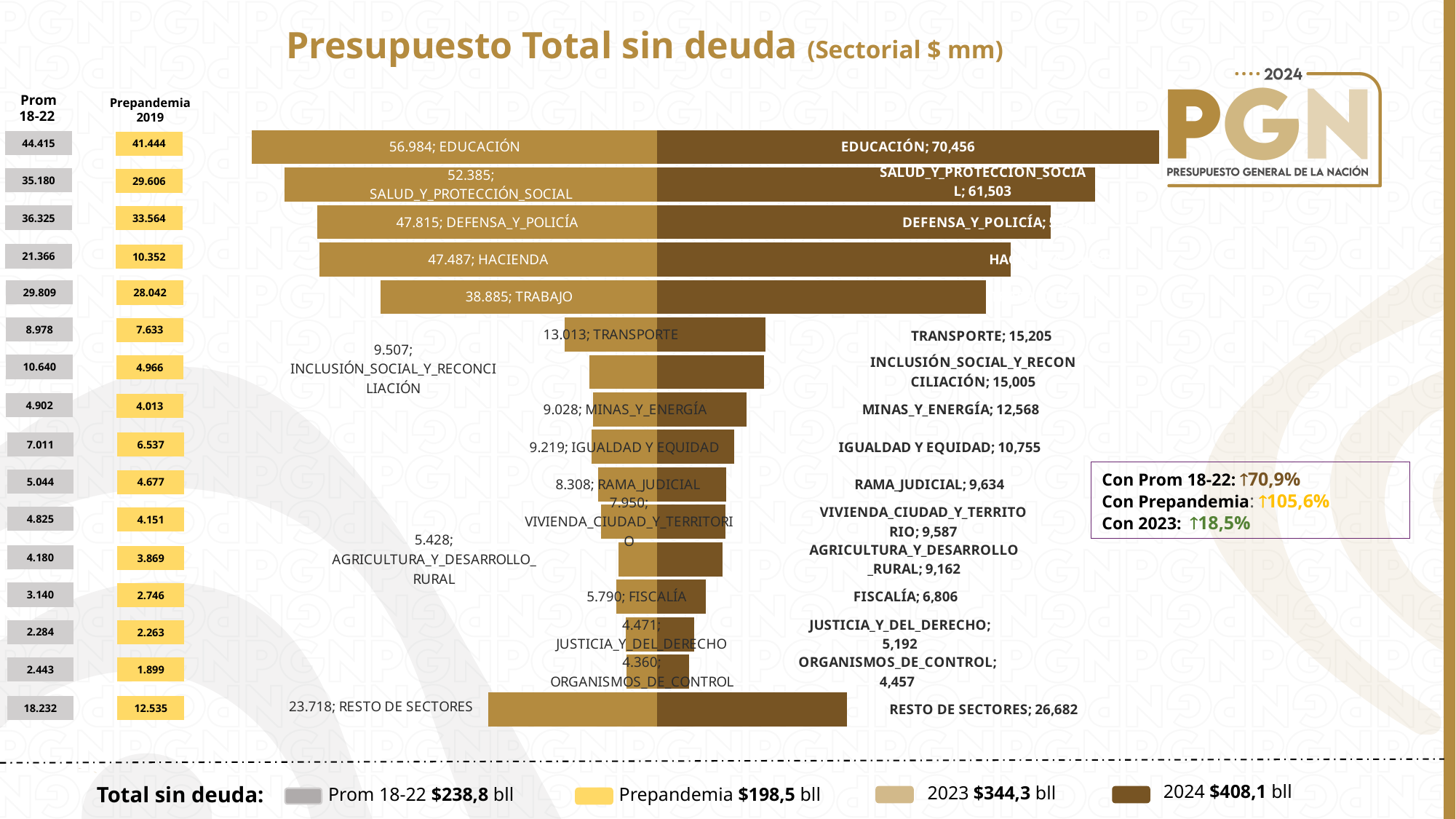
Which sector has the lowest 2023 value? ORGANISMOS_DE_CONTROL What is the 2024 value for RESTO DE SECTORES? 26,682 What is the difference between the 2023 values for EDUCACIÓN and SALUD_Y_PROTECCIÓN_SOCIAL? 4.599 What is the 2023 value for EDUCACIÓN? 56.984 What is the title of the chart? Presupuesto Total sin deuda (Sectorial $ mm) Which is larger in 2023, TRANSPORTE or MINAS_Y_ENERGÍA? TRANSPORTE What kind of chart is shown on the slide? Bar chart How many sectors are plotted in the chart? 16 What is the 2023 value for TRABAJO? 38.885 What is the difference between the 2024 values for TRANSPORTE and INCLUSIÓN_SOCIAL_Y_RECONCILIACIÓN? 200 What is the 2024 value for SALUD_Y_PROTECCIÓN_SOCIAL? 61,503 Which sector has the highest 2024 value? EDUCACIÓN